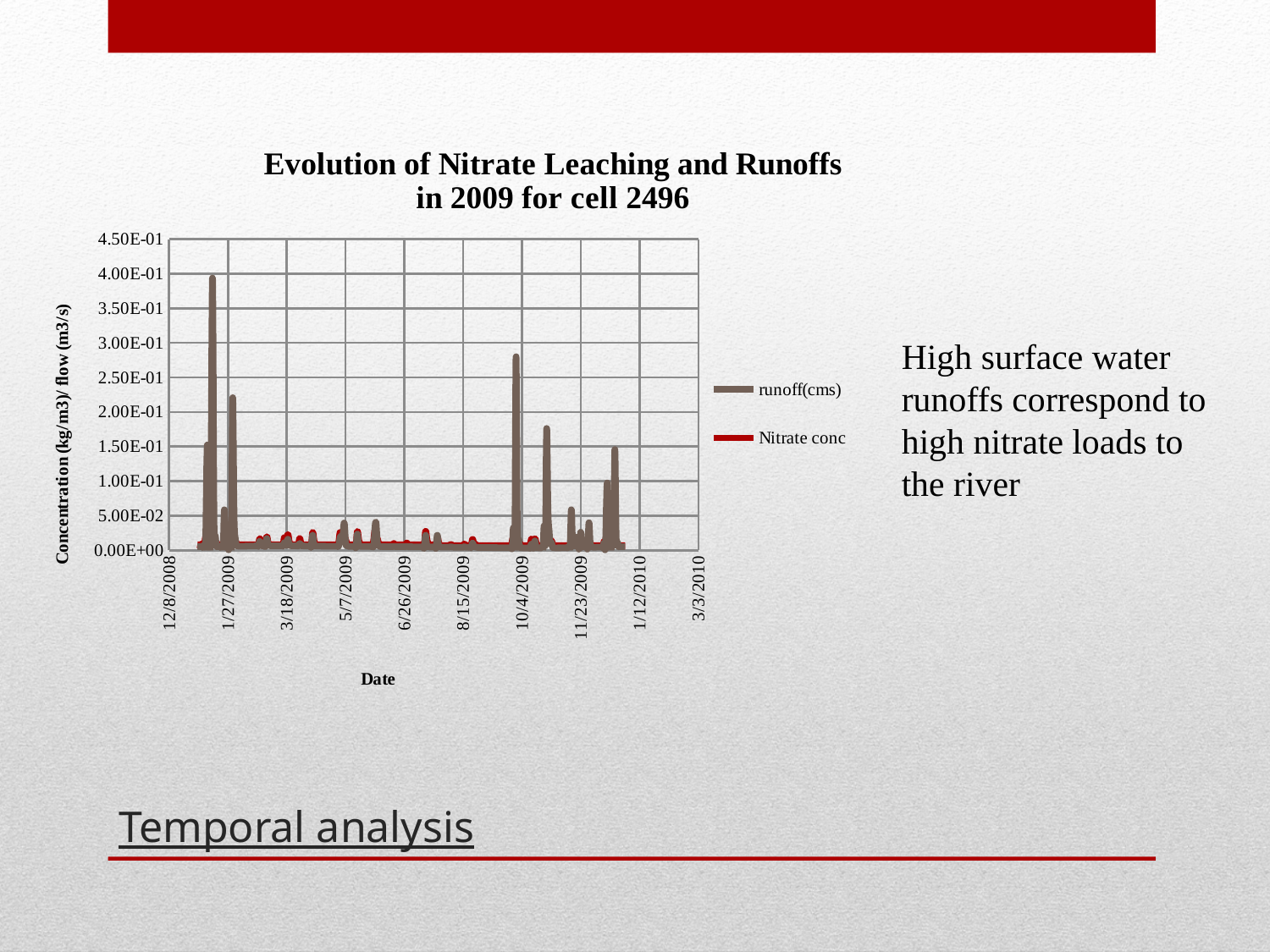
Is the highest peak of runoff(cms) greater or less than 3.50E-01? greater What kind of chart is shown on the slide? line chart What is the label of the x axis? Date Which series reaches the highest peak in the chart, runoff(cms) or Nitrate conc? runoff(cms) Is the Nitrate conc series ever greater or less than 5.00E-02 across the whole period? less Is the peak of runoff(cms) near 1/27/2009 greater or less than 3.00E-01? less How many date labels are shown on the x axis? 10 What is the highest value shown on the y axis? 4.50E-01 Which series is drawn in red in the chart? Nitrate conc What is the title of the chart? Evolution of Nitrate Leaching and Runoffs in 2009 for cell 2496 How many series does the legend list? 2